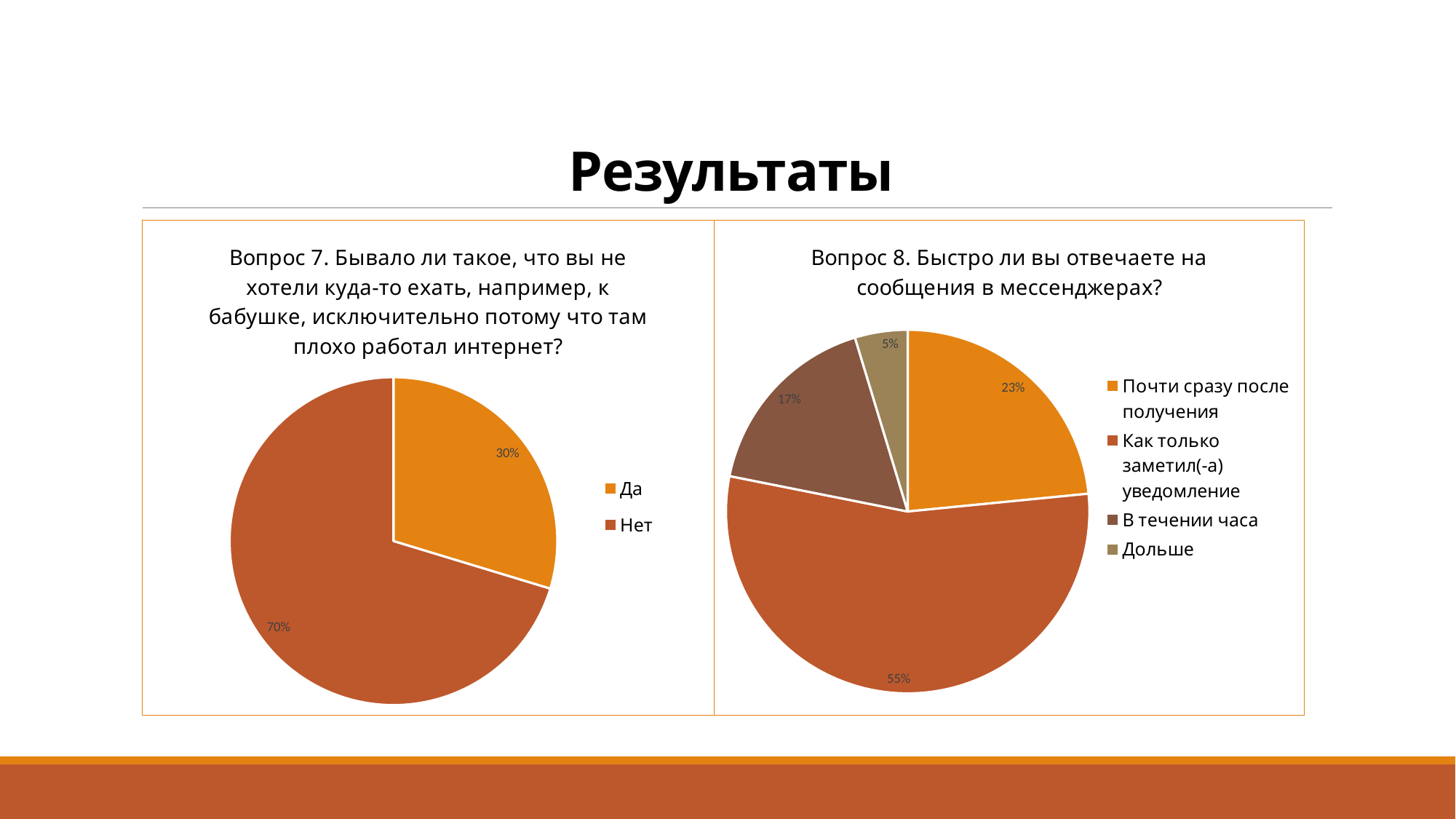
In the right chart (Вопрос 8), what share of respondents answered "Как только заметил(-а) уведомление"? 55% In the right chart (Вопрос 8), which is larger: the share for "В течении часа" or for "Почти сразу после получения"? Почти сразу после получения In the right chart (Вопрос 8), which answer has the smallest share? Дольше In the left chart (Вопрос 7), which answer has the larger share? Нет How many slices does the right chart (Вопрос 8) have? 4 In the left chart (Вопрос 7), what share of respondents answered "Да"? 30% What kind of chart is the left chart (Вопрос 7)? Pie chart In the right chart (Вопрос 8), which answer has the largest share? Как только заметил(-а) уведомление In the left chart (Вопрос 7), what is the difference between the "Нет" and "Да" shares? 40% In the right chart (Вопрос 8), what share of respondents answered "Почти сразу после получения"? 23% In the left chart (Вопрос 7), what share of respondents answered "Нет"? 70% In the right chart (Вопрос 8), what share of respondents answered "Дольше"? 5%